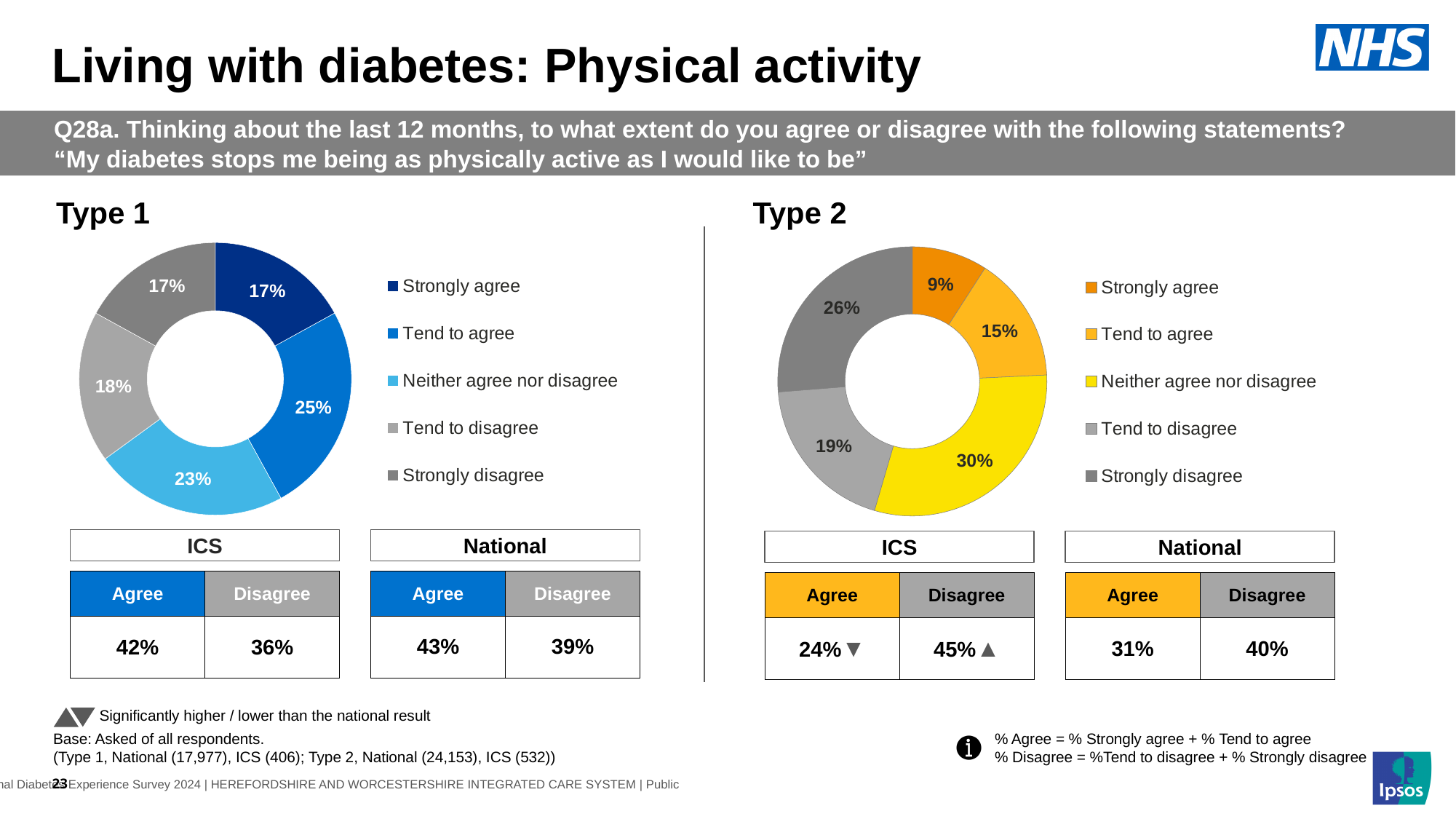
In the Type 2 chart, what percentage of respondents said 'Strongly disagree'? 26% In the Type 2 chart, what is the difference between the 'Strongly disagree' and 'Strongly agree' shares? 17% In the Type 1 chart, what percentage of respondents said 'Tend to disagree'? 18% How many response categories does the legend of the Type 2 chart list? 5 In the Type 2 chart, which response category has the largest share? Neither agree nor disagree In the Type 2 chart, which response category has the smallest share? Strongly agree In the Type 1 chart, which response category has the largest share? Tend to agree In the Type 2 chart, what percentage of respondents said 'Neither agree nor disagree'? 30% In the Type 1 chart, what percentage of respondents said 'Tend to agree'? 25% In the Type 1 chart, what colour represents 'Strongly agree'? Dark blue In the Type 1 chart, which is larger: 'Neither agree nor disagree' or 'Tend to disagree'? Neither agree nor disagree What type of chart is used for the Type 1 results? Donut (pie) chart